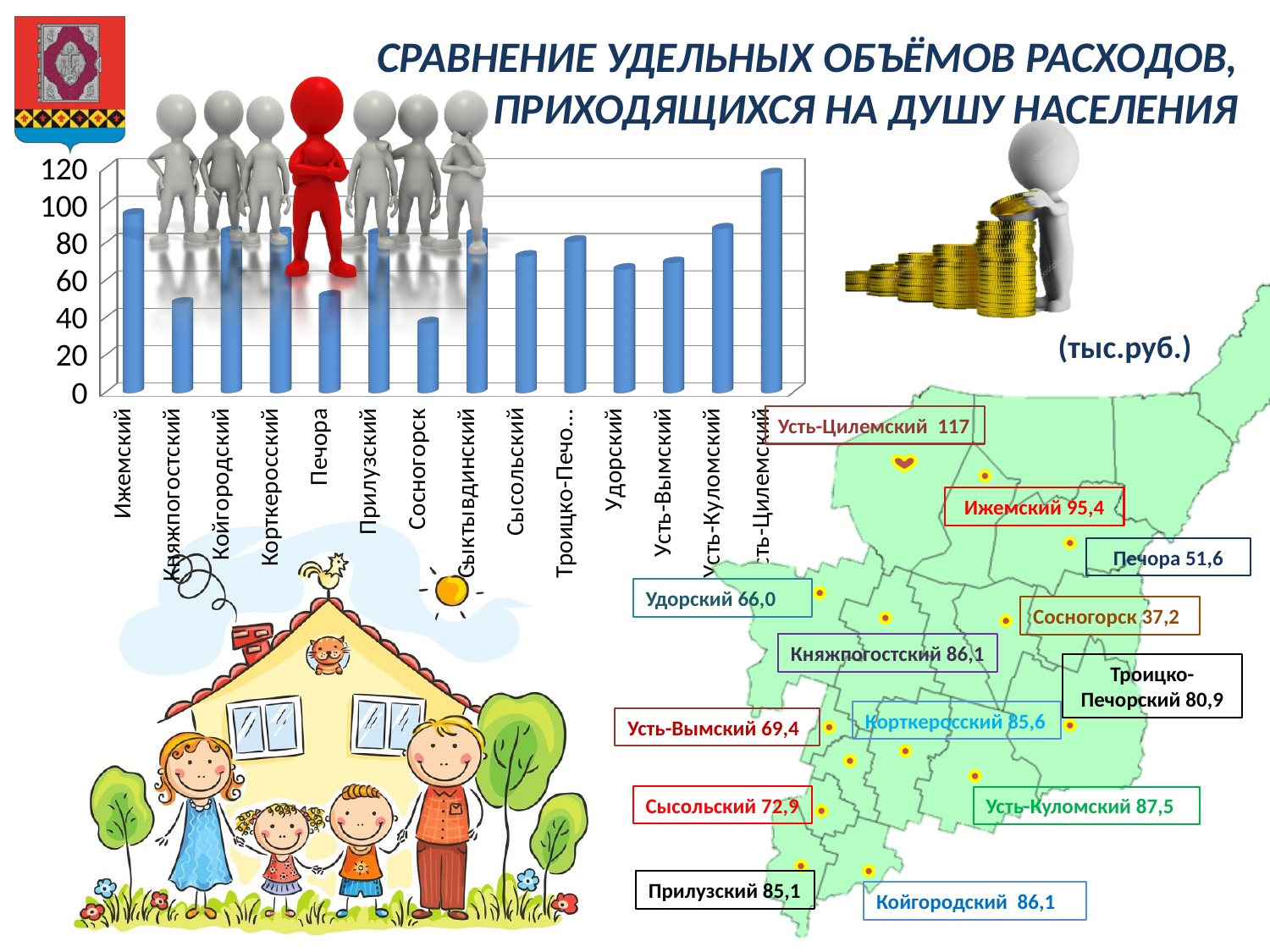
Which is larger, the value for Сысольский or the value for Удорский? Сысольский Which district has the highest bar on the chart? Усть-Цилемский According to the value printed on the slide, what is the per-capita expenditure for Усть-Цилемский? 117 Is the value for Усть-Цилемский greater or less than 100? greater According to the value printed on the slide, what is the per-capita expenditure for Сосногорск? 37,2 Which is larger, the value for Ижемский or the value for Печора? Ижемский Is the value for Сосногорск greater or less than 40? less How many districts (categories) are plotted on the bar chart? 14 In what units are the values on the slide expressed? тыс.руб. Is the value for Печора greater or less than 60? less Which district has the lowest bar on the chart? Сосногорск What kind of chart is shown on the slide? bar chart